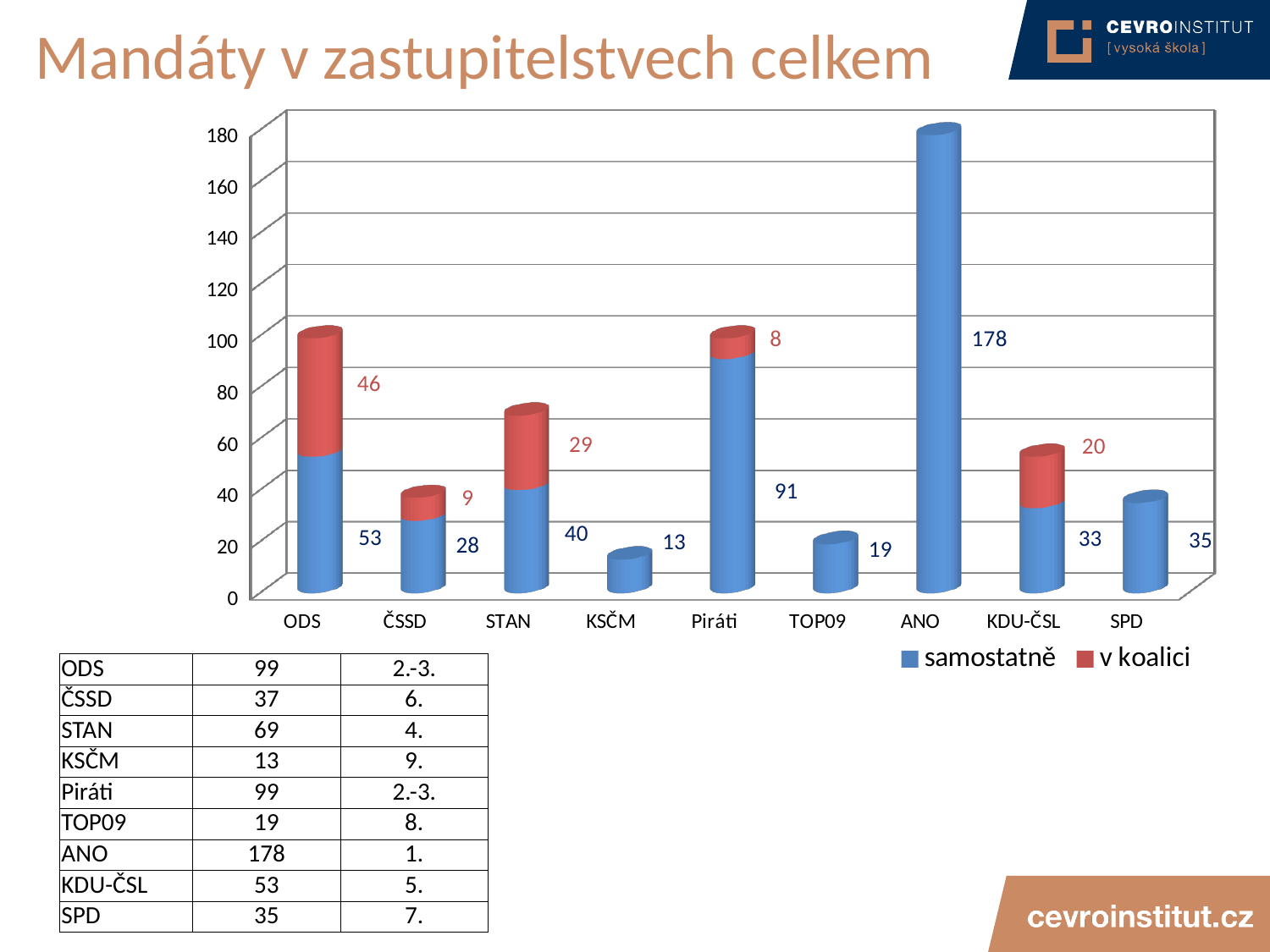
What is the value of the "samostatně" series for Piráti? 91 Which category has the lowest "samostatně" value? KSČM What is the value of the "samostatně" series for ANO? 178 Which is larger, the "samostatně" value for SPD or for KDU-ČSL? SPD What kind of chart is shown on the slide? Stacked bar chart What is the title of the slide? Mandáty v zastupitelstvech celkem What is the value of the "v koalici" series for ODS? 46 How many categories are shown on the x axis? 9 What is the difference between the "v koalici" values for STAN and KDU-ČSL? 9 Which category has the highest "samostatně" value? ANO How many series does the legend list? 2 What is the total of the stacked bar for STAN? 69